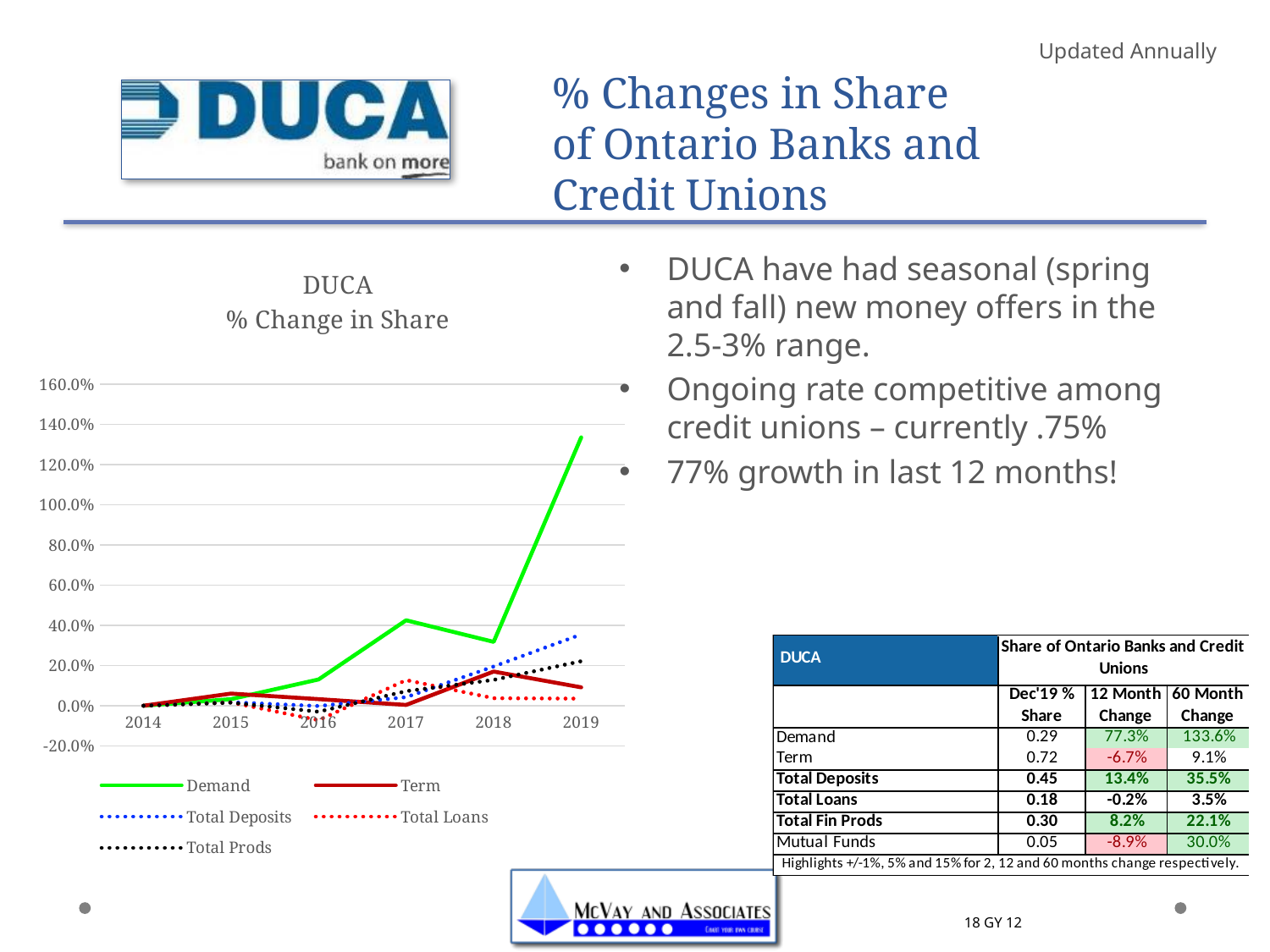
In the 'DUCA % Change in Share' chart, in which year does the Demand series reach its highest value? 2019 What kind of chart is the 'DUCA % Change in Share' chart? line chart In the 'DUCA % Change in Share' chart, is the value for Demand in 2019 greater or less than 120.0%? greater In the 'DUCA % Change in Share' chart, does the Demand series rise or fall from 2018 to 2019? rise In the 'DUCA % Change in Share' chart, is the value for Demand in 2018 greater or less than 40.0%? less In the 'DUCA % Change in Share' chart, which series has the highest value in 2019? Demand How many years are shown on the x axis of the 'DUCA % Change in Share' chart? 6 In the 'DUCA % Change in Share' chart, which is larger in 2019: Total Deposits or Total Loans? Total Deposits In the 'DUCA % Change in Share' chart, what colour is the Demand line? green In the 'DUCA % Change in Share' chart, is the value for Total Deposits in 2019 greater or less than 20.0%? greater How many series does the legend of the 'DUCA % Change in Share' chart list? 5